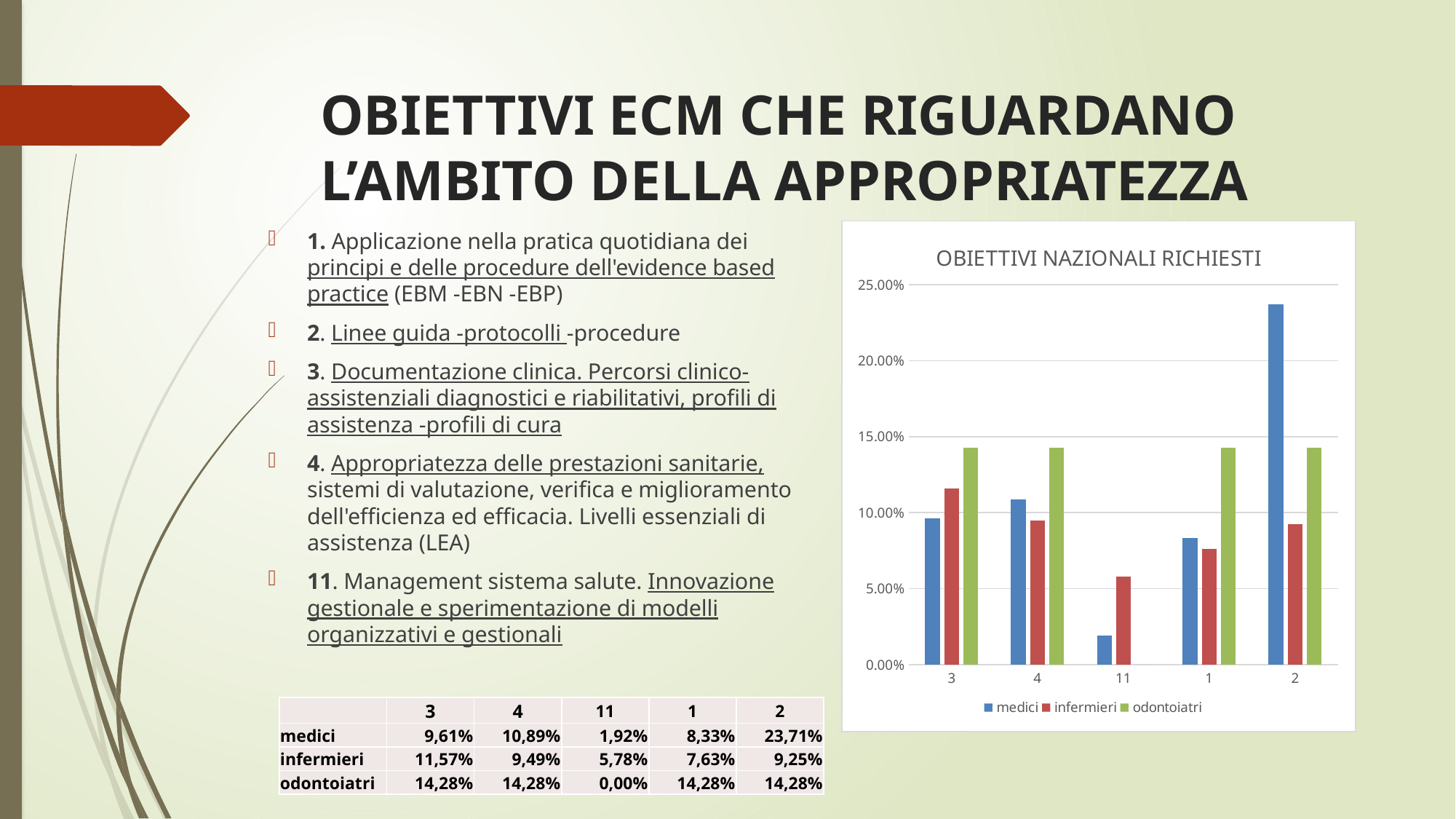
In category 4, which is larger: the value for medici or for infermieri? medici What is the value for medici in category 2? 23,71% What type of chart is shown on the slide? bar chart Which category has the highest value for medici? 2 Is the value for medici in category 2 greater or less than 20.00%? greater What is the value for odontoiatri in category 11? 0,00% How many categories are shown on the x axis of the chart? 5 Which category has the lowest value for infermieri? 11 What is the value for infermieri in category 3? 11,57% What is the difference between the medici and infermieri values in category 2? 14,46% How many series does the chart legend list? 3 What is the title of the chart? OBIETTIVI NAZIONALI RICHIESTI